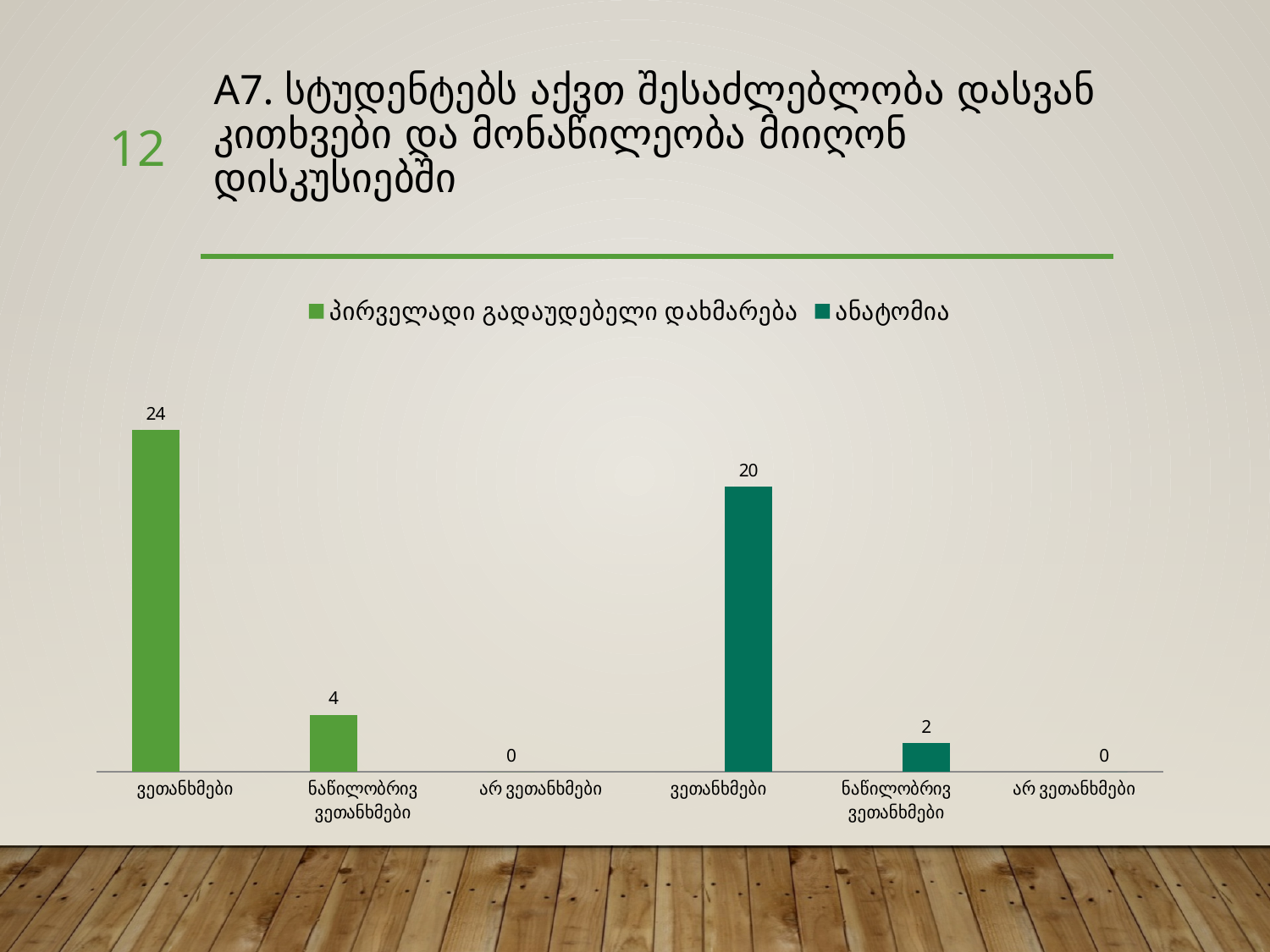
What is the difference between the ვეთანხმები values of the პირველადი გადაუდებელი დახმარება and ანატომია series? 4 What is the value for ნაწილობრივ ვეთანხმები in the პირველადი გადაუდებელი დახმარება series? 4 What kind of chart is shown on the slide? bar chart What is the value for ვეთანხმები in the პირველადი გადაუდებელი დახმარება series? 24 What is the value for ნაწილობრივ ვეთანხმები in the ანატომია series? 2 What is the value for არ ვეთანხმები in the ანატომია series? 0 Which bar has the highest value on the chart? ვეთანხმები (პირველადი გადაუდებელი დახმარება) What is the value for ვეთანხმები in the ანატომია series? 20 Which is larger: ნაწილობრივ ვეთანხმები for პირველადი გადაუდებელი დახმარება or ნაწილობრივ ვეთანხმები for ანატომია? პირველადი გადაუდებელი დახმარება How many series does the legend list? 2 What colour are the bars of the ანატომია series? dark green